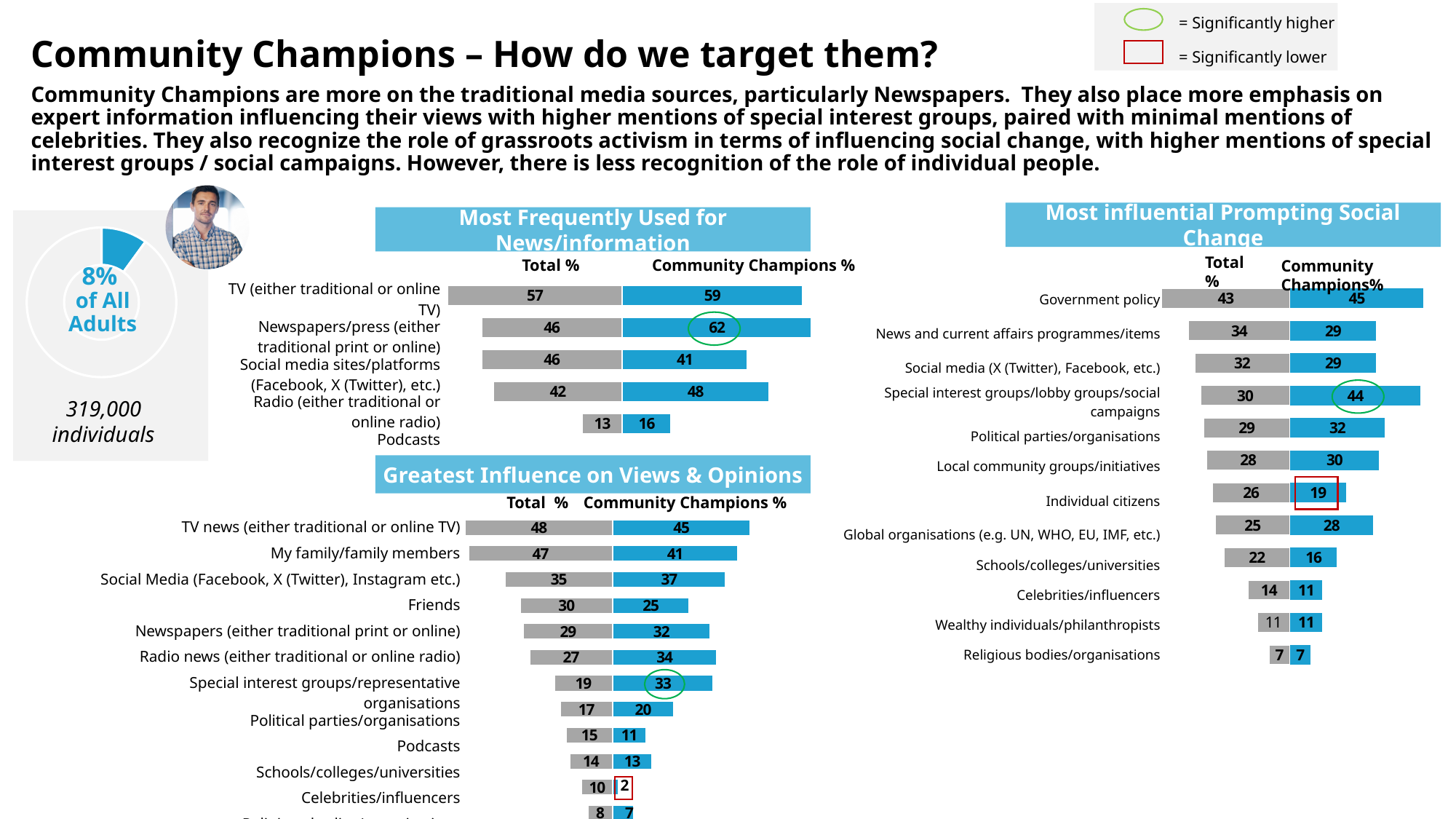
In the 'Most influential Prompting Social Change' chart, what is the difference between the Total % and the Community Champions % for Individual citizens? 7 In the 'Most Frequently Used for News/information' chart, what is the Total % for Podcasts? 13 In the 'Greatest Influence on Views & Opinions' chart, which is larger for Friends: the Total % or the Community Champions %? Total % How many categories are shown in the 'Most influential Prompting Social Change' chart? 12 In the 'Most Frequently Used for News/information' chart, what is the Community Champions % for Newspapers/press (either traditional print or online)? 62 In the 'Most Frequently Used for News/information' chart, what is the difference between the Community Champions % and the Total % for Newspapers/press? 16 In the 'Greatest Influence on Views & Opinions' chart, what is the Community Champions % for Celebrities/influencers? 2 In the 'Most influential Prompting Social Change' chart, what is the Community Champions % for Special interest groups/lobby groups/social campaigns? 44 In the 'Most influential Prompting Social Change' chart, which category has the lowest Total %? Religious bodies/organisations In the 'Most Frequently Used for News/information' chart, which category has the highest Total %? TV (either traditional or online TV) In the 'Greatest Influence on Views & Opinions' chart, which category has the highest Community Champions %? TV news (either traditional or online TV) In the 'Greatest Influence on Views & Opinions' chart, what is the Community Champions % for Special interest groups/representative organisations? 33